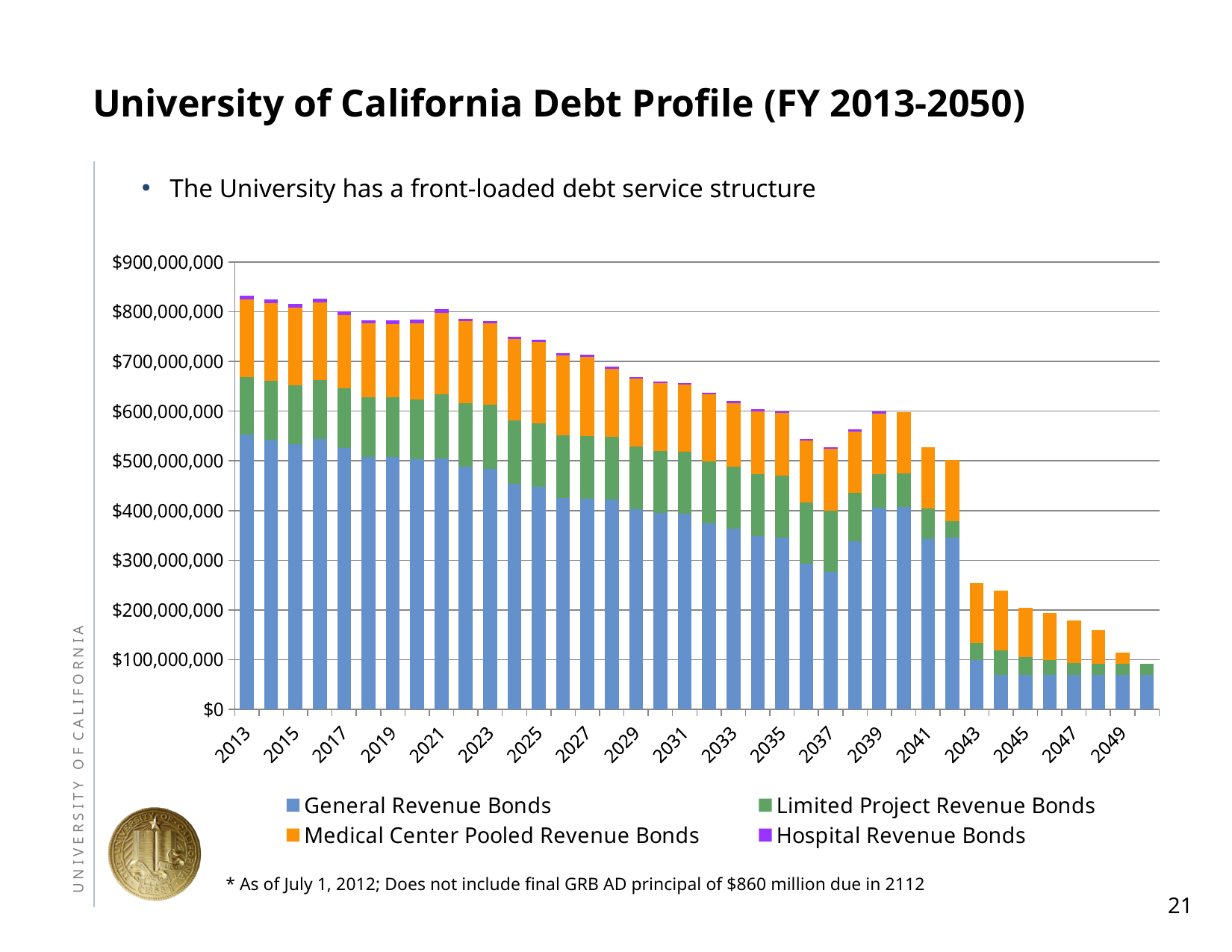
What kind of chart is shown on the slide? Stacked bar chart How many series does the legend list? 4 Is the total debt service for 2043 greater or less than $200,000,000? greater Which series is shown in blue in the legend? General Revenue Bonds Which year has the larger total debt service, 2013 or 2043? 2013 Which year has the lowest total debt service in the chart? 2050 Is the total debt service for 2050 greater or less than $100,000,000? less Is the General Revenue Bonds value for 2013 greater or less than $500,000,000? greater Do the total bar heights generally rise or fall from 2013 to 2050? Fall Which series is shown in orange in the legend? Medical Center Pooled Revenue Bonds